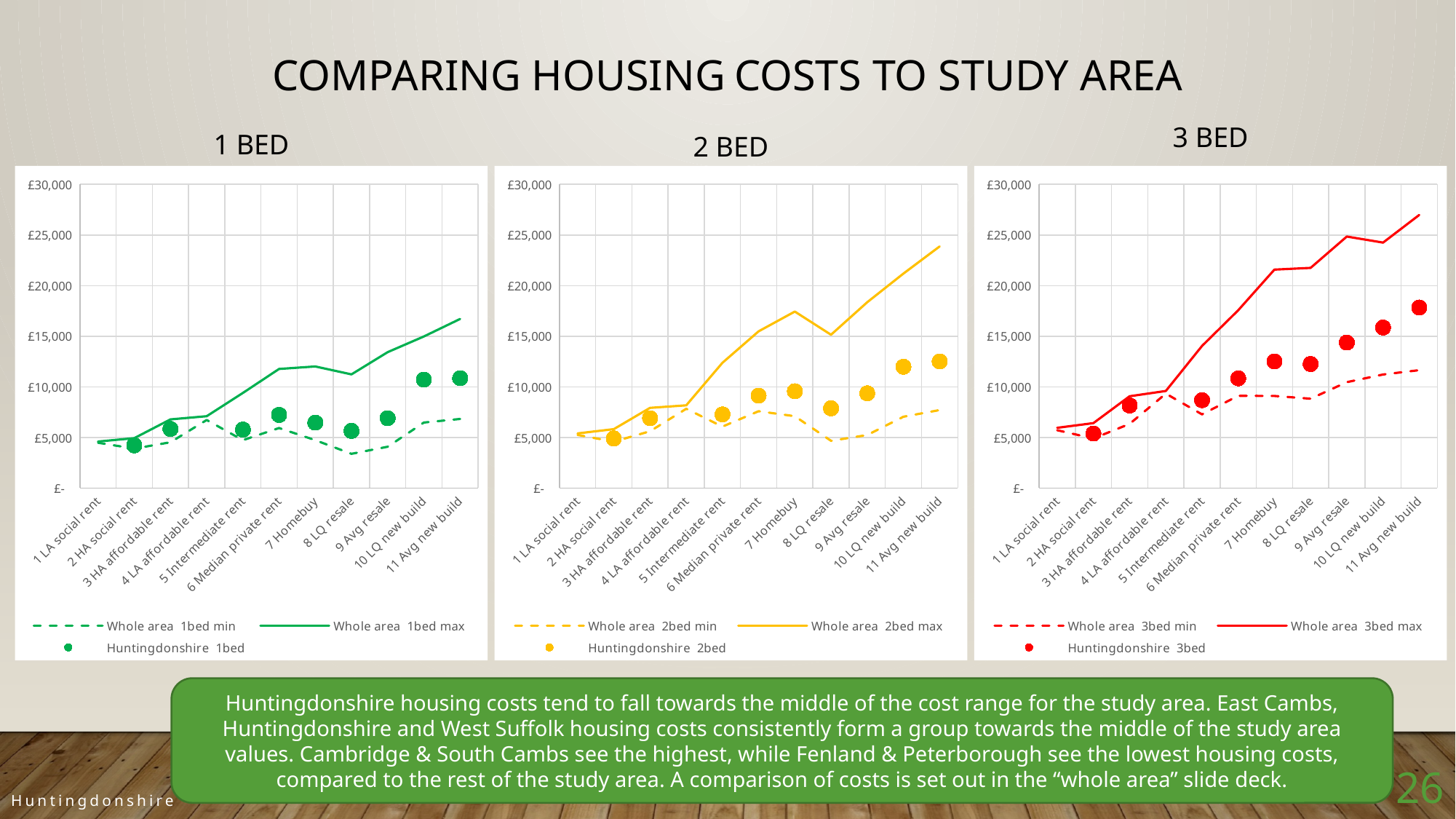
In the 3 BED chart, is the value of Whole area 3bed max at 11 Avg new build greater or less than £25,000? greater In the 1 BED chart, is the Huntingdonshire 1bed value at 2 HA social rent greater or less than £5,000? less In the 2 BED chart, does the Whole area 2bed max series generally rise or fall from 1 LA social rent to 11 Avg new build? Rise In the 2 BED chart, is the value of Whole area 2bed max at 11 Avg new build greater or less than £20,000? greater How many series does the legend of the 3 BED chart list? 3 In the 3 BED chart, at which category is the Huntingdonshire 3bed value lowest? 2 HA social rent How many charts are on the slide? 3 In the 3 BED chart, which is larger at 11 Avg new build: Whole area 3bed max or Huntingdonshire 3bed? Whole area 3bed max What kind of chart is the 1 BED chart? Line chart How many categories are shown on the x axis of the 2 BED chart? 11 In the 3 BED chart, at which category is the Huntingdonshire 3bed value highest? 11 Avg new build